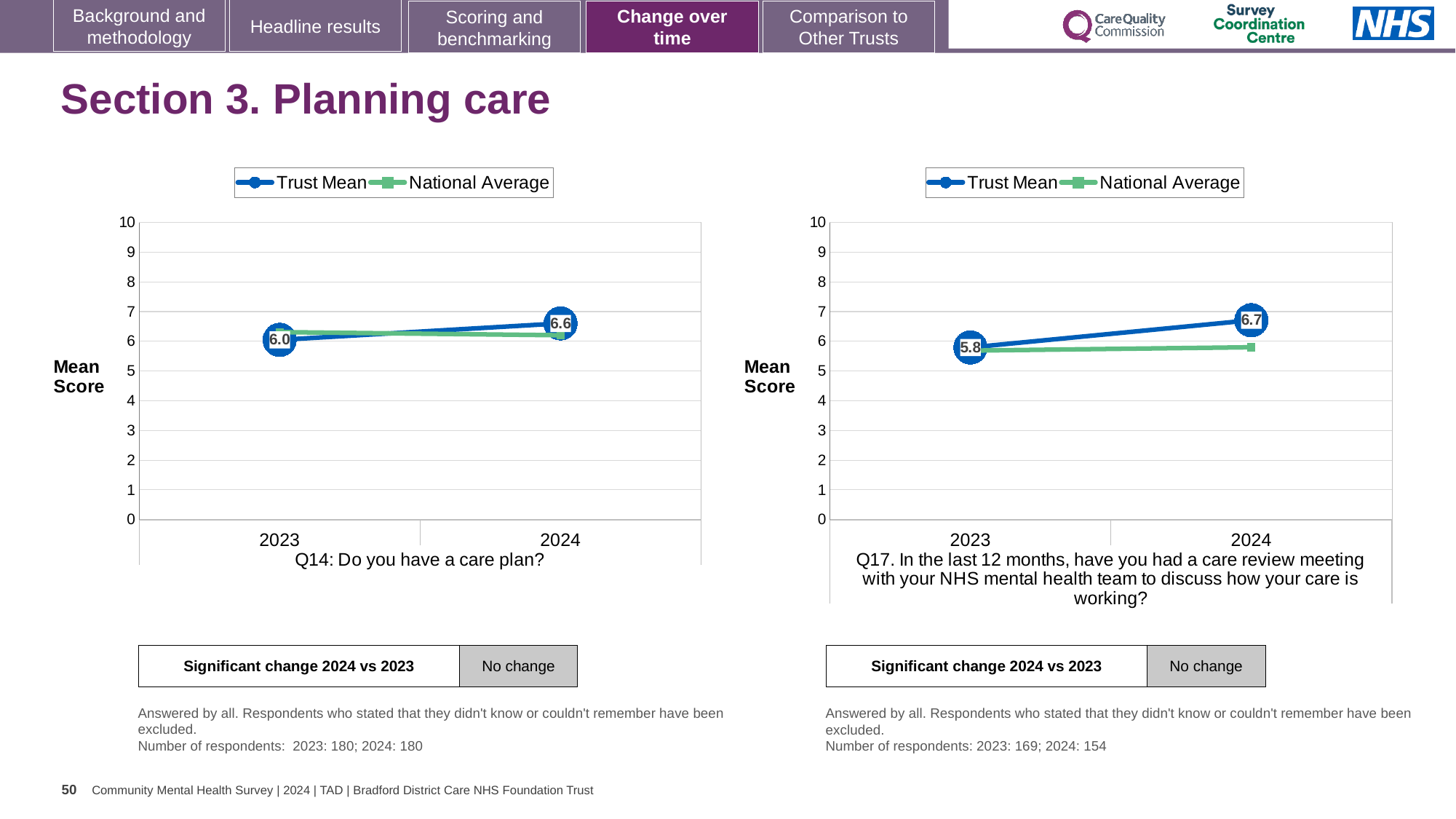
In the Q17 chart (right), what is the Trust Mean score for 2024? 6.7 In the Q17 chart (right), is the Trust Mean for 2024 larger or smaller than the National Average for 2024? larger In the Q14 chart (left), what is the Trust Mean score for 2024? 6.6 What kind of chart is the Q17 chart (right)? line chart In the Q14 chart (left), by how much did the Trust Mean change from 2023 to 2024? 0.6 In the Q14 chart (left), what is the Trust Mean score for 2023? 6.0 In the Q17 chart (right), what is the difference between the Trust Mean in 2024 and in 2023? 0.9 In the Q14 chart (left), which year has the higher Trust Mean score? 2024 In the Q17 chart (right), does the Trust Mean rise or fall from 2023 to 2024? rise How many series does the legend of the Q14 chart (left) list? 2 In the Q17 chart (right), is the National Average value for 2023 greater or less than 6? less In the Q17 chart (right), what is the Trust Mean score for 2023? 5.8